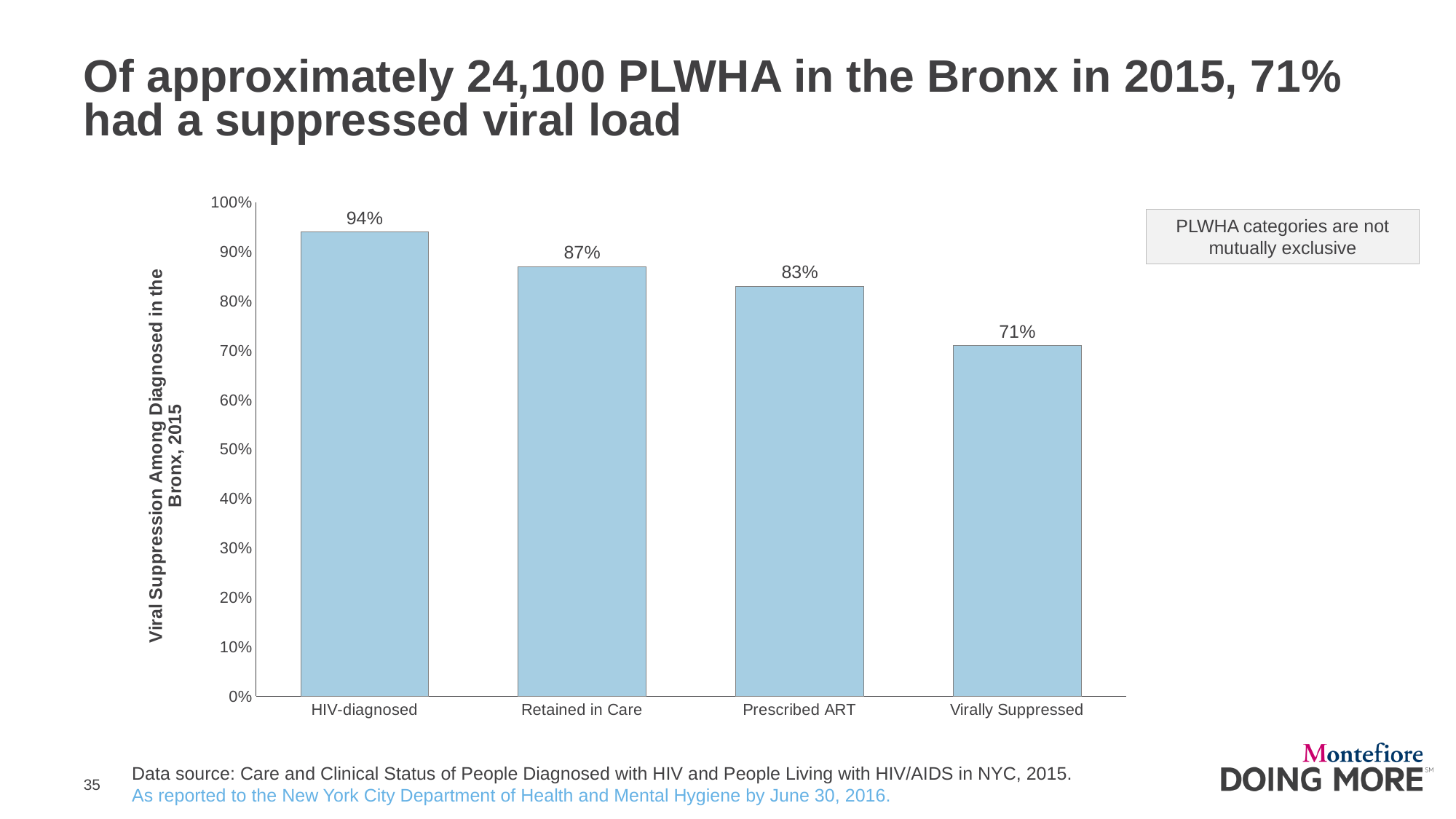
How many categories are shown on the x axis? 4 What is the value for HIV-diagnosed? 94% What is the difference between the values for Retained in Care and Prescribed ART? 4% What kind of chart is shown on the slide? Bar chart What is the value for Prescribed ART? 83% Which is larger, the value for Retained in Care or the value for Virally Suppressed? Retained in Care Which category has the lowest value? Virally Suppressed Do the values rise or fall from left to right along the x axis? Fall What is the value for Retained in Care? 87% What is the value for Virally Suppressed? 71% Which category has the highest value? HIV-diagnosed What is the difference between the values for HIV-diagnosed and Virally Suppressed? 23%